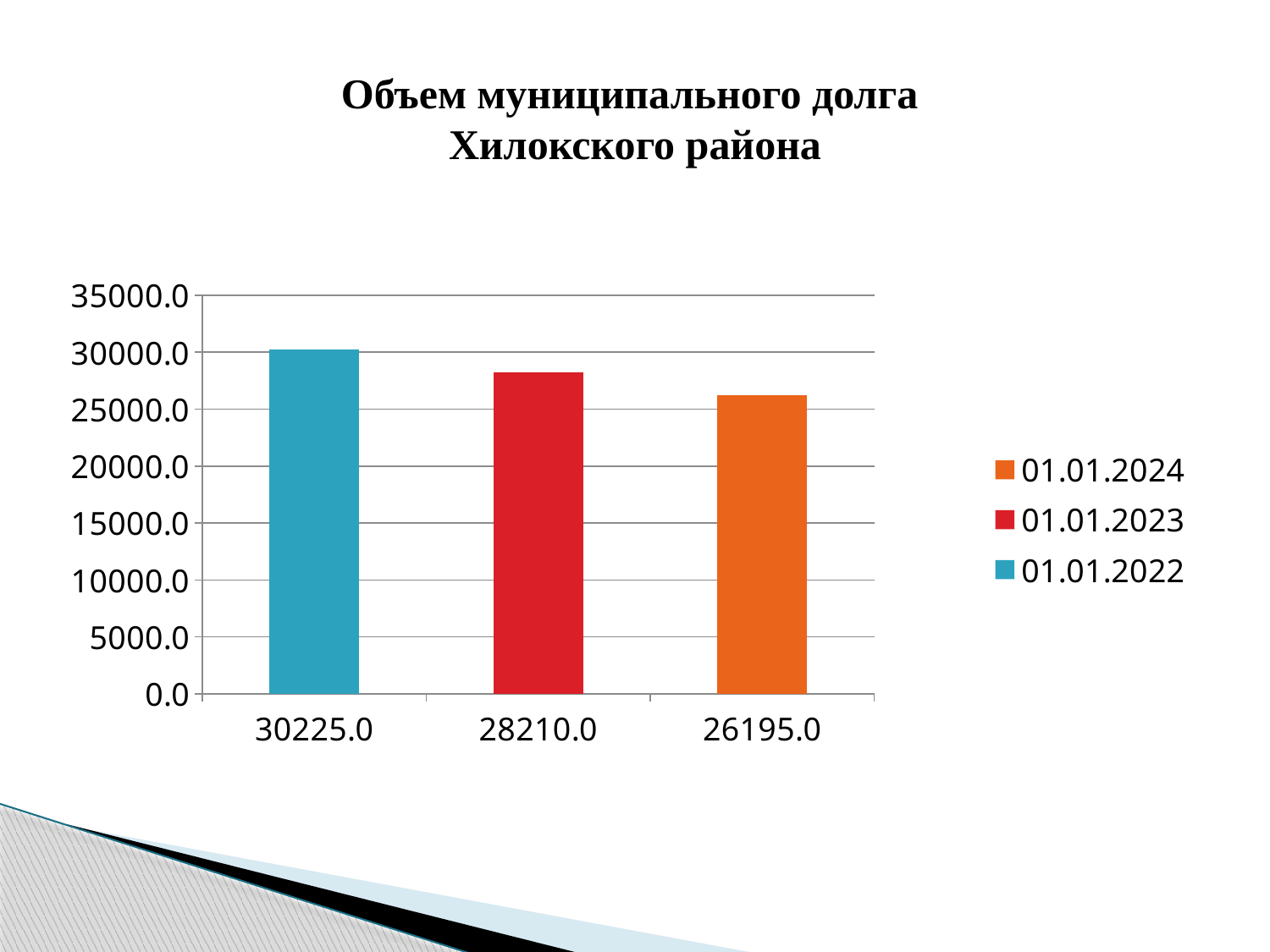
How many series does the legend list? 3 How many bars are plotted in the chart? 3 What is the difference between the values 30225.0 and 26195.0? 4030.0 Which series has the lowest bar? 01.01.2024 What is the title of the chart? Объем муниципального долга Хилокского района What value is printed under the red bar (01.01.2023)? 28210.0 Which series has the highest bar? 01.01.2022 What kind of chart is shown on the slide? bar chart Is the value for 01.01.2023 greater or less than 30000.0? less What value is printed under the orange bar (01.01.2024)? 26195.0 What value is printed under the blue bar (01.01.2022)? 30225.0 Do the bar values rise or fall from left to right? fall